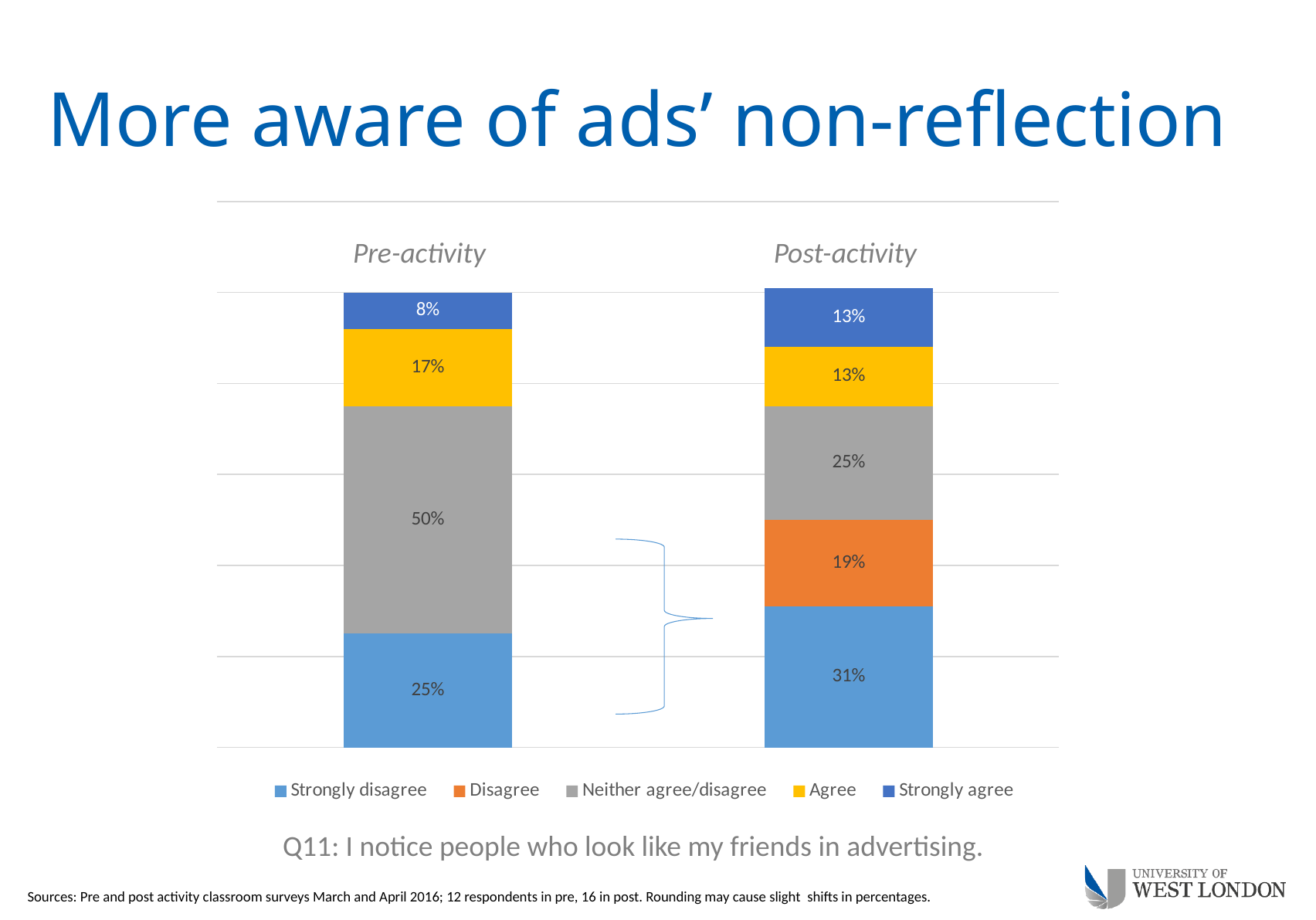
Which segment is the smallest in the Pre-activity bar? Strongly agree What is the difference between the Neither agree/disagree values for Pre-activity and Post-activity? 25% How many bars are plotted in the chart? 2 What survey question does the chart relate to, as stated below the chart? Q11: I notice people who look like my friends in advertising. Which segment is the largest in the Pre-activity bar? Neither agree/disagree What is the value for Strongly disagree in the Pre-activity bar? 25% What is the value for Disagree in the Post-activity bar? 19% Which is larger: Strongly disagree in Pre-activity or Strongly disagree in Post-activity? Post-activity What kind of chart is shown on the slide? Stacked bar chart What is the value for Strongly agree in the Pre-activity bar? 8% What is the value for Neither agree/disagree in the Post-activity bar? 25% How many series does the legend list? 5